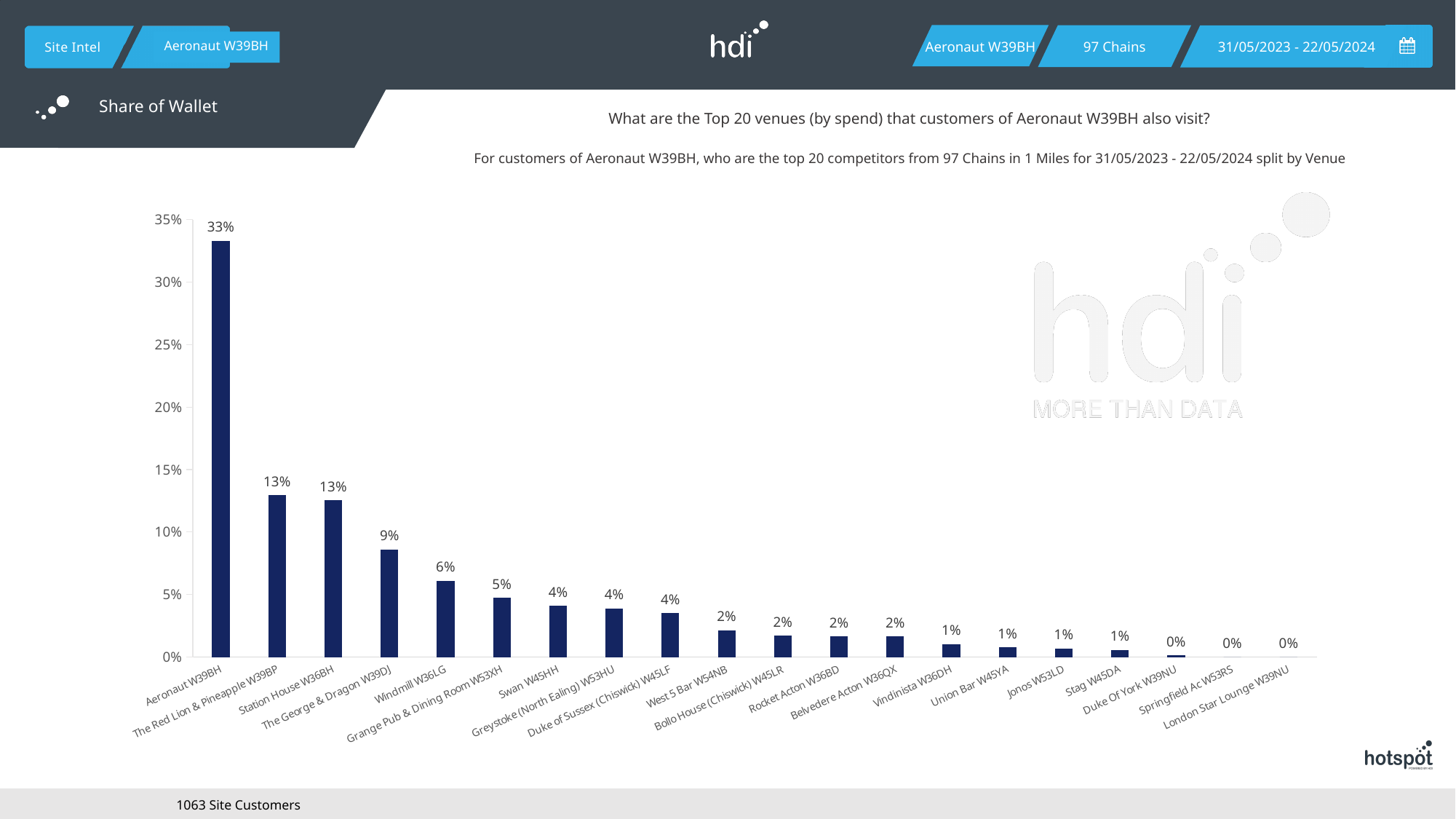
What is the value for Windmill W36LG? 6% What is the value for Aeronaut W39BH? 33% Which venue has the highest value? Aeronaut W39BH How many venues are shown on the chart? 20 Which has a larger value, Windmill W36LG or Swan W45HH? Windmill W36LG What kind of chart is shown? bar chart What is the difference between the values for Aeronaut W39BH and The Red Lion & Pineapple W39BP? 20% Is the value for Aeronaut W39BH greater or less than 30%? greater What is the value for Grange Pub & Dining Room W53XH? 5% What is the value for The George & Dragon W39DJ? 9% What is the value for Vindinista W36DH? 1% Do the values rise or fall from left to right along the x axis? fall